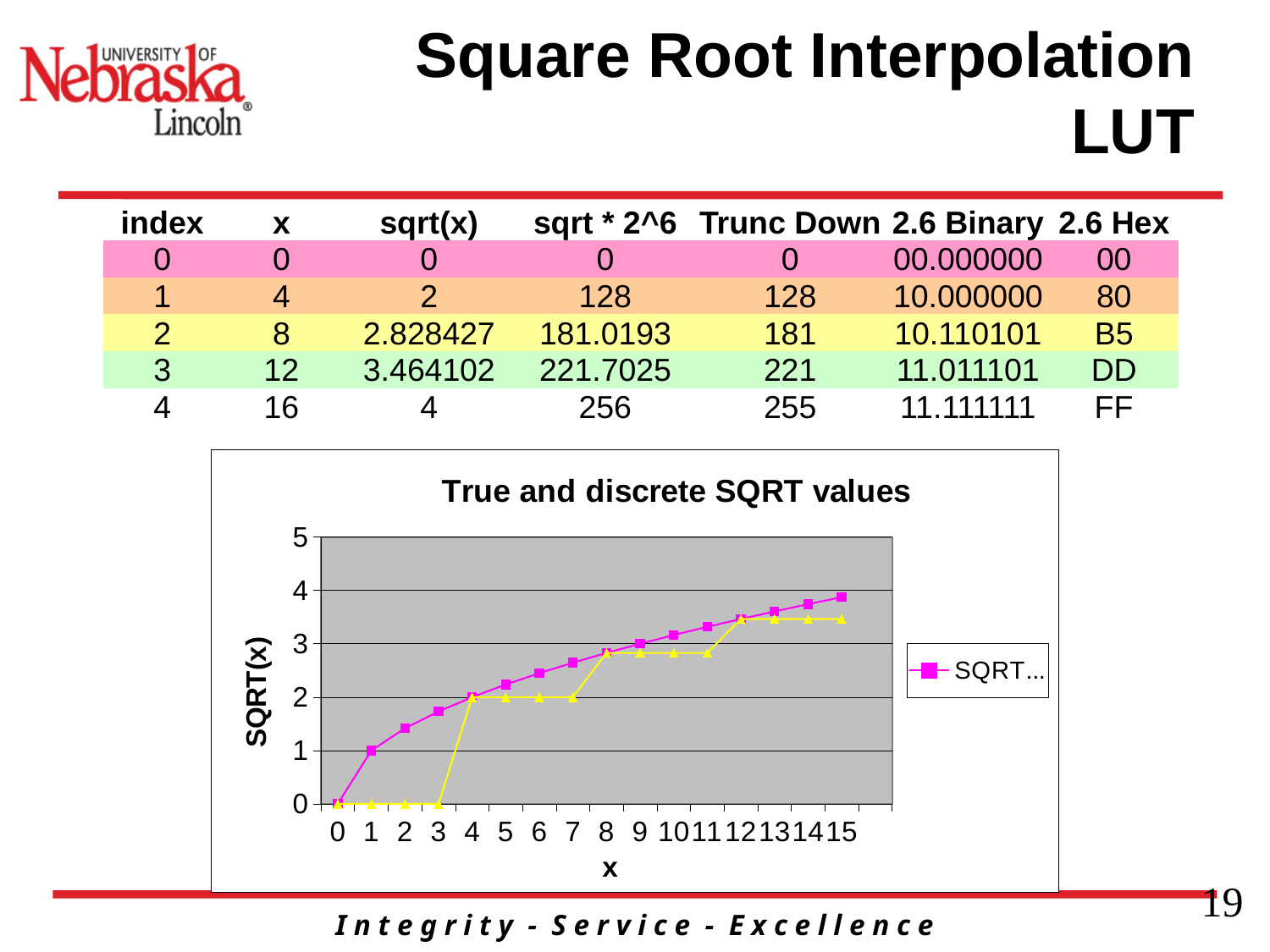
What is the value of the magenta square series at x = 4? 2 What is the value of the magenta square series at x = 9? 3 How many x values are plotted along the horizontal axis of the chart? 16 What kind of chart is shown on the slide? line chart At which x value does the magenta square series reach its highest point? 15 What is the value of the magenta square series at x = 1? 1 What is the label on the vertical axis of the chart? SQRT(x) What is the value of the yellow triangle series at x = 6? 2 Is the value of the magenta square series at x = 15 greater or less than 3? greater Do the values of the magenta square series rise or fall as x increases? rise At x = 3, which series has the larger value, the magenta square series or the yellow triangle series? magenta square series What is the title of the chart? True and discrete SQRT values